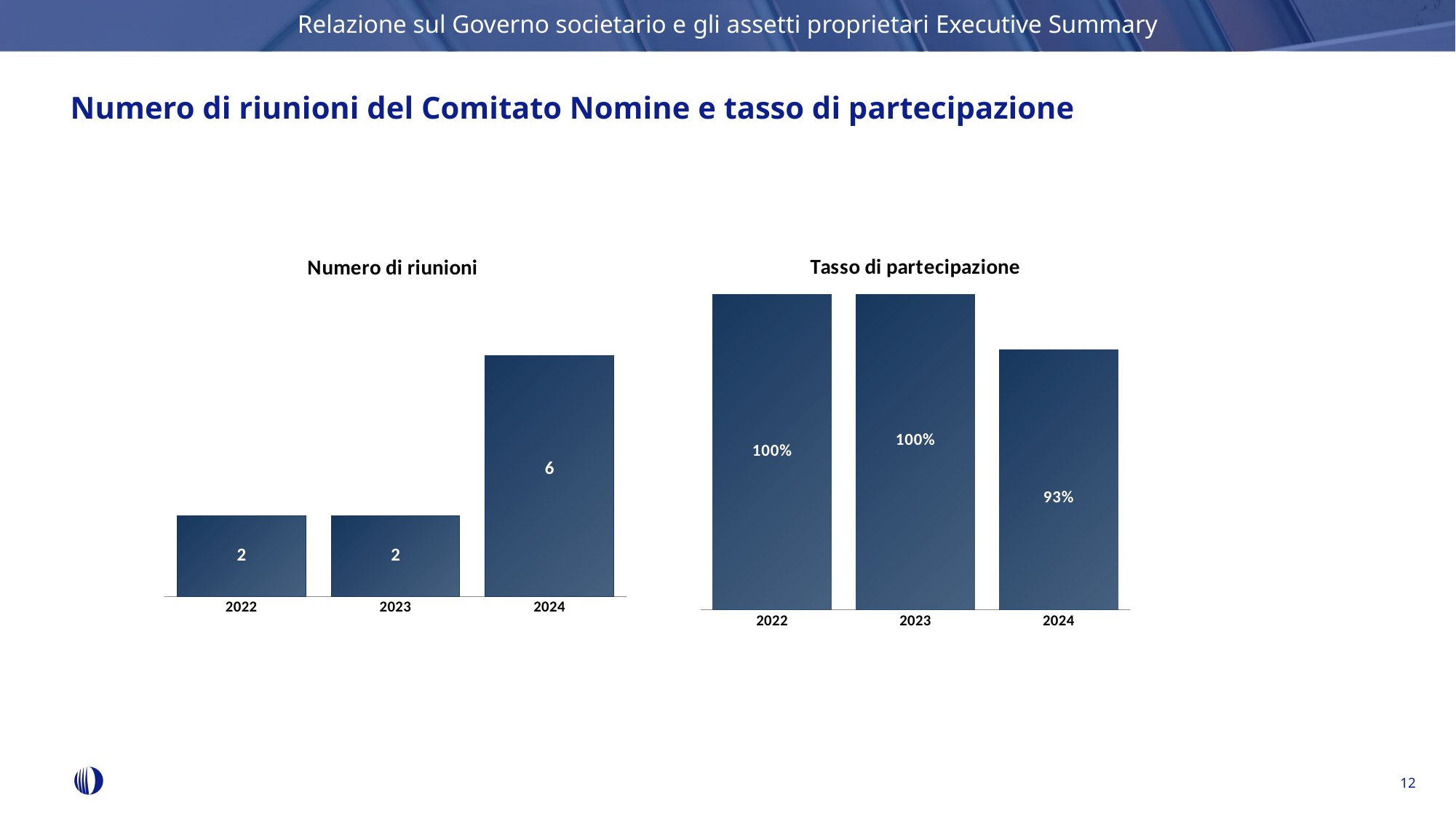
In the 'Tasso di partecipazione' chart, what is the difference between the values for 2022 and 2024? 7% In the 'Tasso di partecipazione' chart, which year has the lowest value? 2024 What is the title of the chart on the left of the slide? Numero di riunioni In the 'Numero di riunioni' chart, which year has the highest value? 2024 In the 'Numero di riunioni' chart, what is the value for 2022? 2 In the 'Tasso di partecipazione' chart, what is the value for 2024? 93% In the 'Numero di riunioni' chart, what is the difference between the values for 2024 and 2023? 4 In the 'Tasso di partecipazione' chart, what is the value for 2023? 100% What kind of chart is the 'Tasso di partecipazione' chart? bar chart How many categories are shown in the 'Numero di riunioni' chart? 3 In the 'Numero di riunioni' chart, what is the value for 2024? 6 In the 'Tasso di partecipazione' chart, is the value for 2023 larger or smaller than the value for 2024? larger